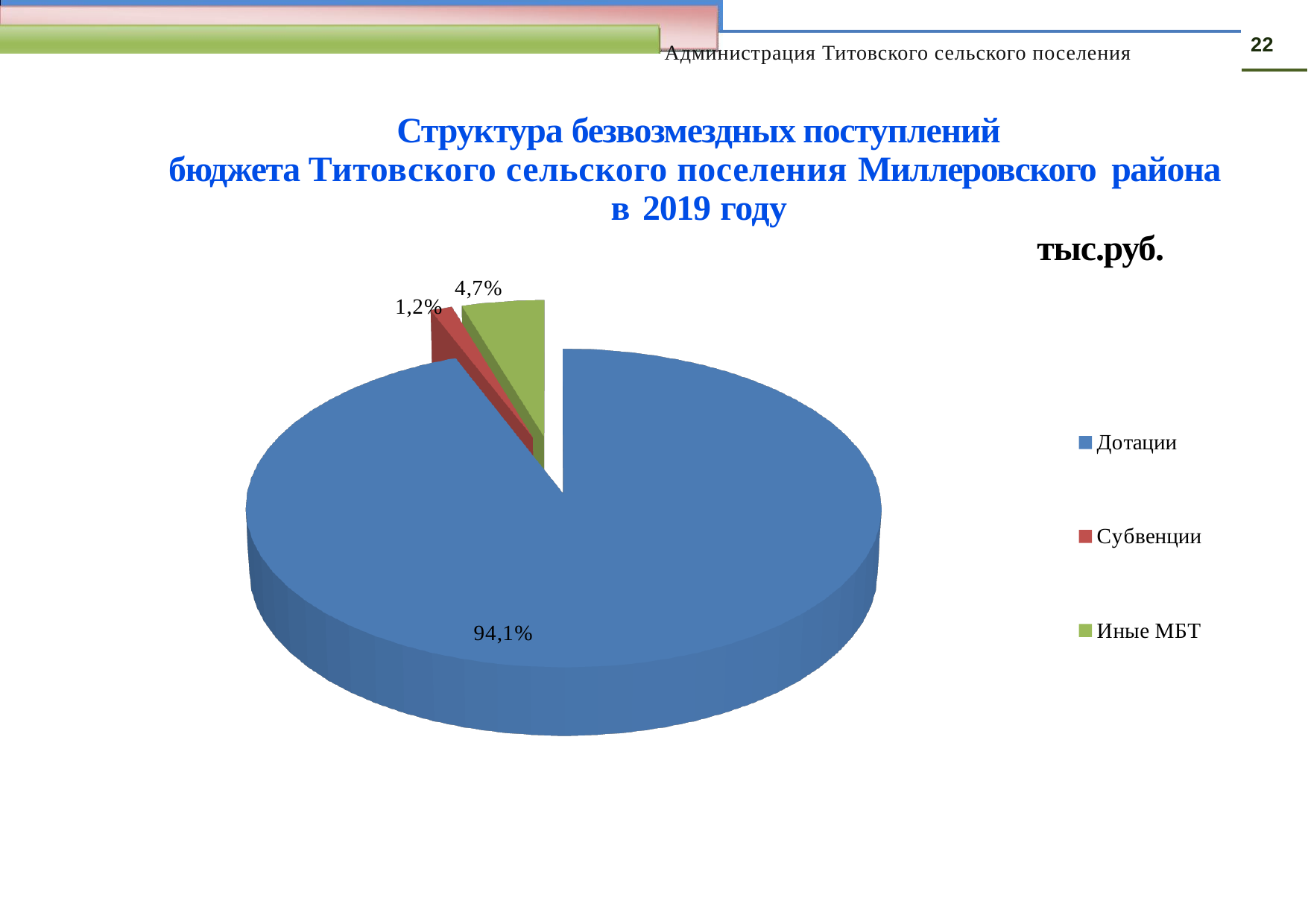
What is the difference in percentage points between the Дотации share and the Иные МБТ share? 89,4% Which category has the largest slice of the pie? Дотации What share of the pie does Субвенции account for? 1,2% How many slices does the pie chart have? 3 Which category has the smallest slice of the pie? Субвенции Which is larger, the share for Иные МБТ or the share for Субвенции? Иные МБТ What colour is the Дотации slice in the pie chart? blue What share of the pie does Дотации account for? 94,1% What is the difference in percentage points between the Иные МБТ share and the Субвенции share? 3,5% What kind of chart is shown on the slide? pie chart How many entries does the legend list? 3 What share of the pie does Иные МБТ account for? 4,7%